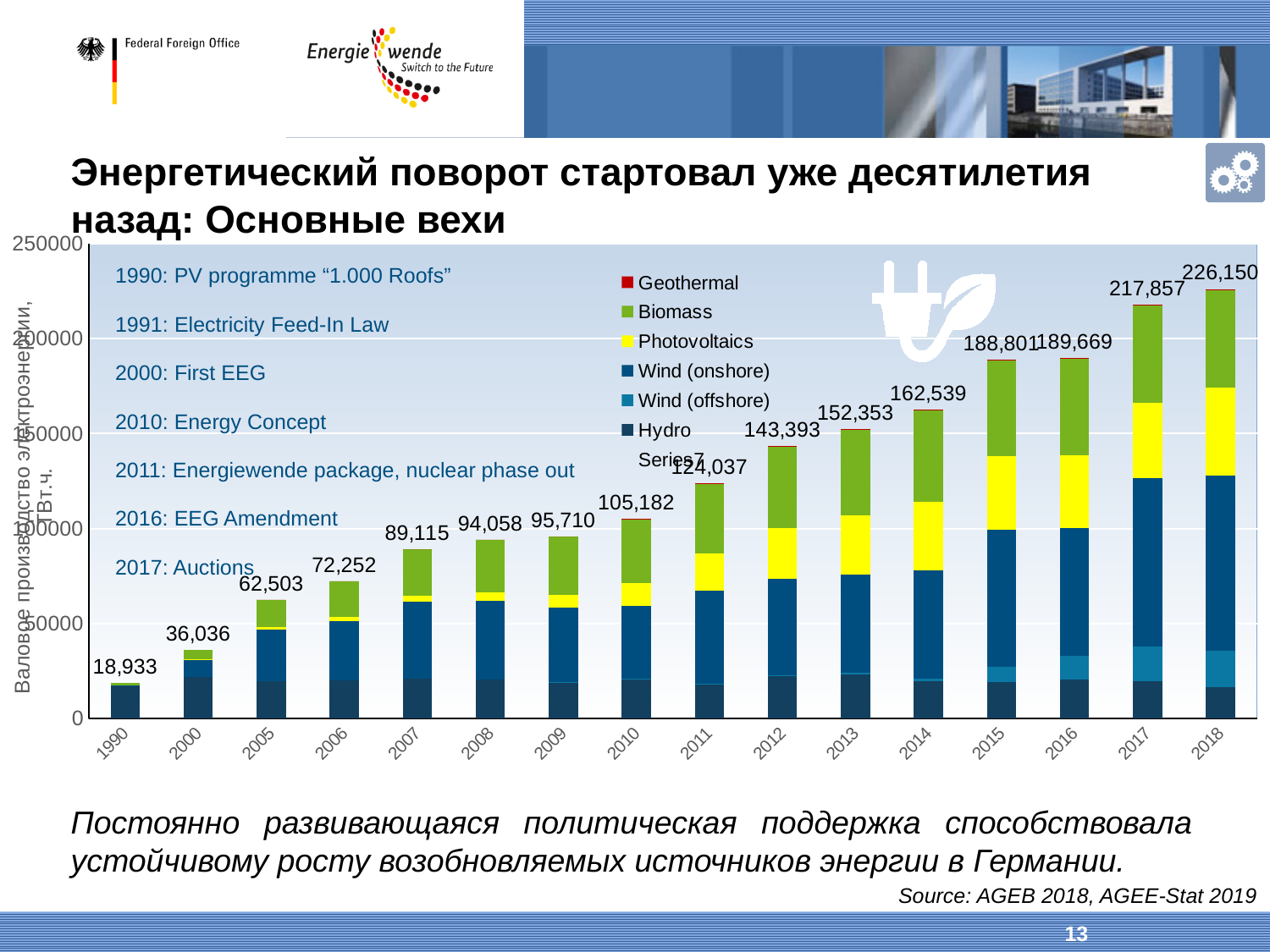
Which year has the highest total value? 2018 How many years are shown on the x axis? 16 What kind of chart is shown? Stacked bar chart What is the total value shown for 2011? 124,037 What is the total value shown for 2018? 226,150 Which year has the lowest total value? 1990 Do the total values rise or fall from 1990 to 2018? Rise Which is larger, the total for 2005 or the total for 2006? 2006 What is the total value shown for 1990? 18,933 Is the total for 2014 greater or less than 150000? greater How many series does the legend list? 7 What is the difference between the total for 2018 and the total for 2017? 8,293